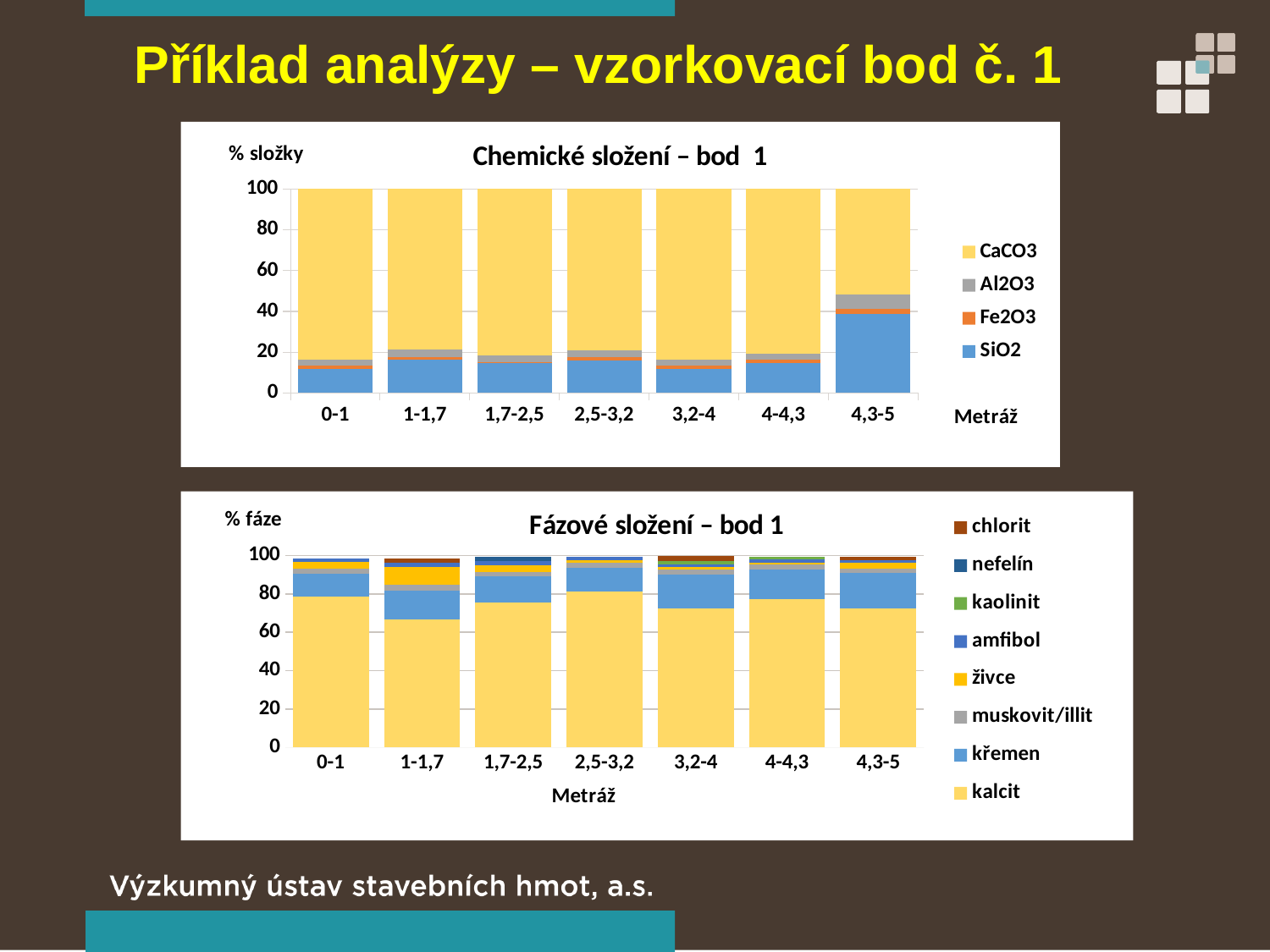
How many series does the legend of the 'Fázové složení – bod 1' chart list? 8 In the 'Chemické složení – bod 1' chart, which category has the smallest CaCO3 segment? 4,3-5 How many categories are shown on the x axis of the 'Chemické složení – bod 1' chart? 7 What type of chart is the 'Chemické složení – bod 1' chart? stacked bar chart How many series does the legend of the 'Chemické složení – bod 1' chart list? 4 In the 'Fázové složení – bod 1' chart, which category has the smallest kalcit segment? 1-1,7 What is the x-axis label of the 'Fázové složení – bod 1' chart? Metráž In the 'Chemické složení – bod 1' chart, is the SiO2 value for 4,3-5 greater or less than 20? greater In the 'Chemické složení – bod 1' chart, which category has the largest SiO2 segment? 4,3-5 How many categories are shown on the x axis of the 'Fázové složení – bod 1' chart? 7 In the 'Fázové složení – bod 1' chart, is the kalcit value for 1-1,7 greater or less than 60? greater In the 'Chemické složení – bod 1' chart, is the SiO2 value for 0-1 greater or less than 20? less